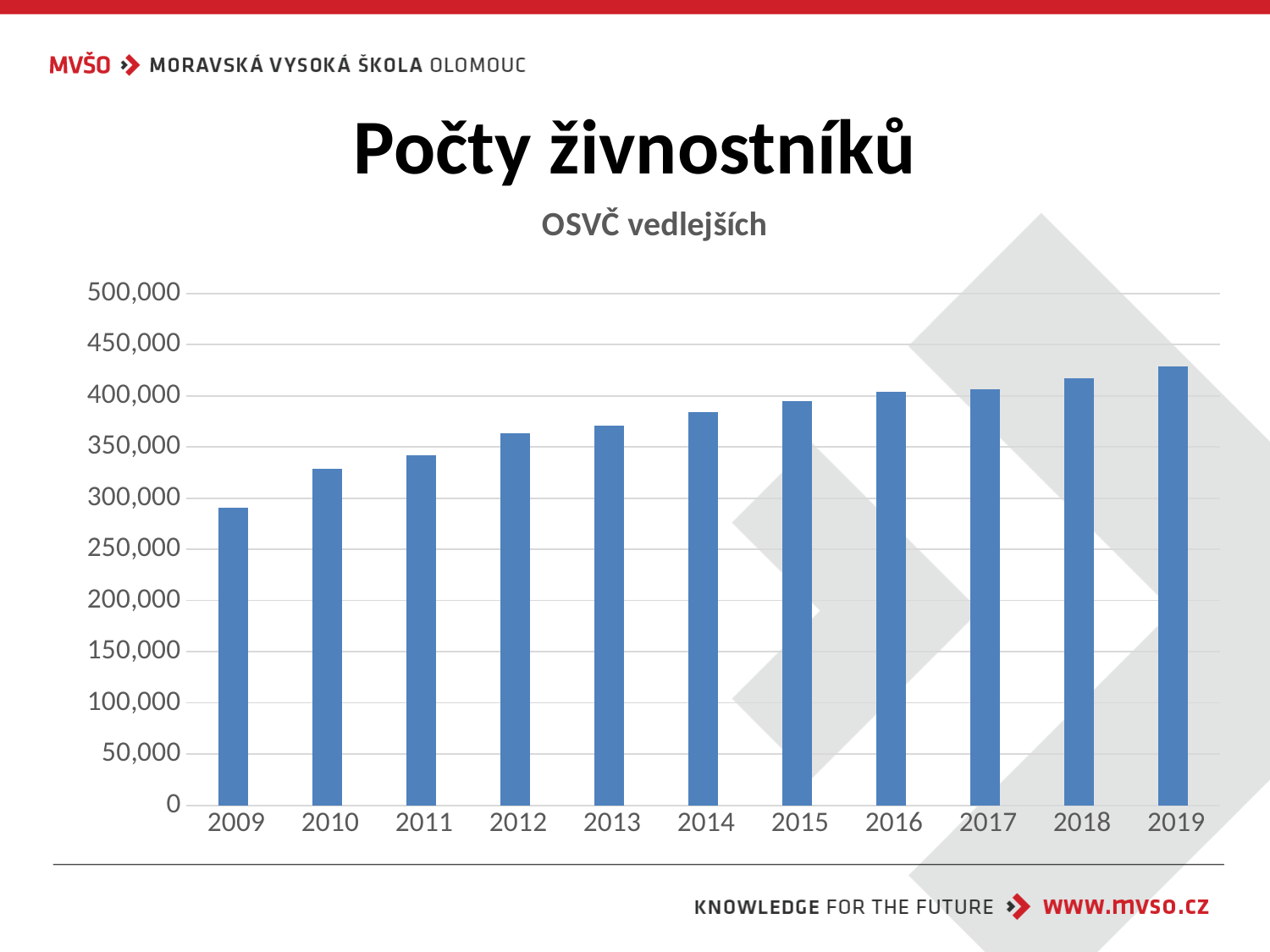
Is the value for 2019 greater or less than 400,000? greater Is the value for 2015 greater or less than 400,000? less Which year has the lowest value in the chart? 2009 Is the value for 2009 greater or less than 300,000? less What colour are the bars in the chart? blue Which year has the highest value in the chart? 2019 How many years are shown on the x axis of the chart? 11 Which is larger, the value for 2010 or the value for 2014? 2014 What is the title of the chart? OSVČ vedlejších Do the values generally rise or fall from 2009 to 2019? rise What kind of chart is shown on the slide? bar chart